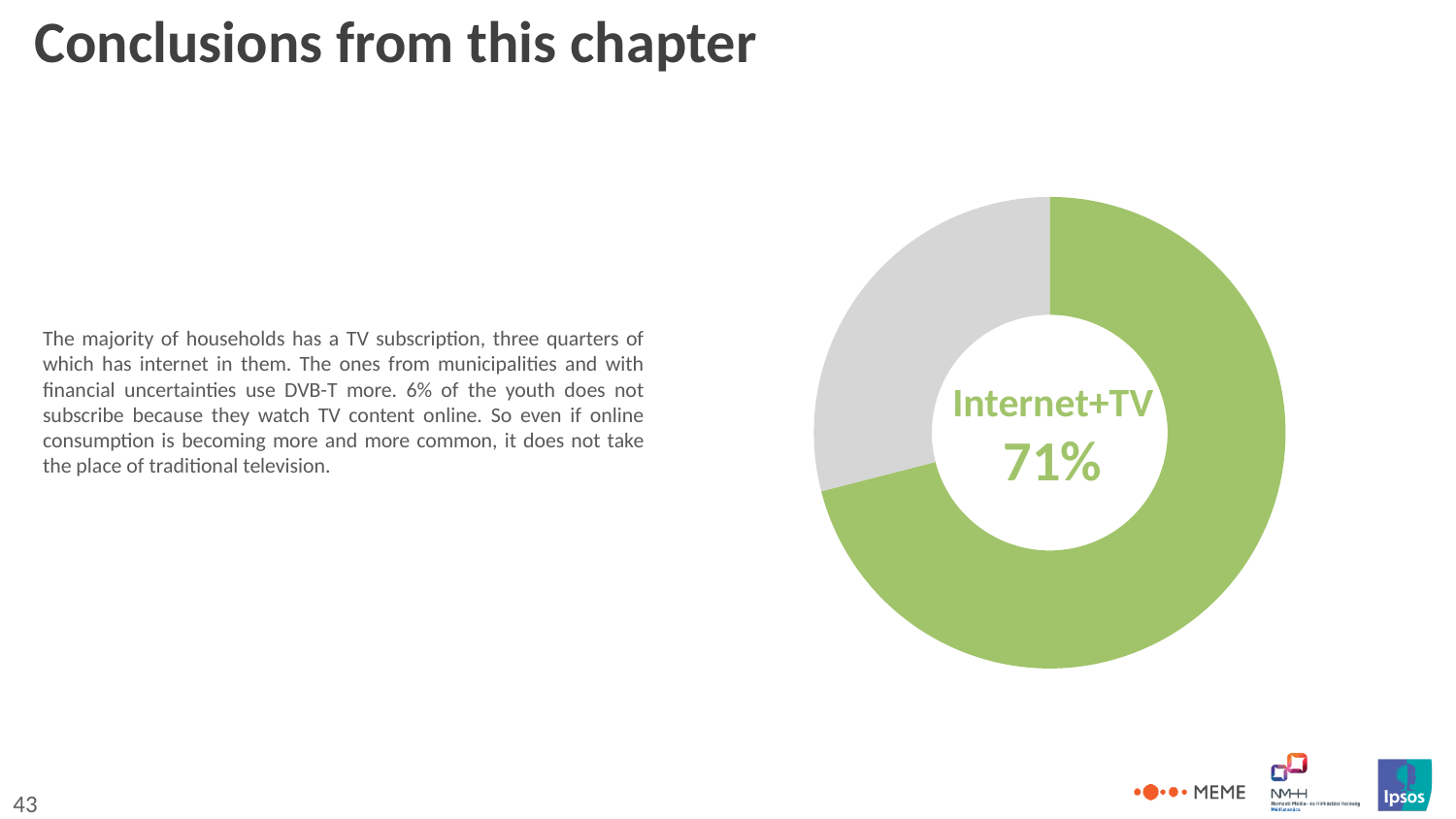
Which slice of the donut chart is larger, the green Internet+TV slice or the grey slice? The green Internet+TV slice How many slices does the donut chart have? 2 What label is printed in the centre of the donut chart? Internet+TV 71% What percentage is shown for Internet+TV in the donut chart? 71% Is the share of the grey slice greater or less than 50%? less Which slice of the donut chart is the largest? Internet+TV What colour is the Internet+TV slice of the donut chart? Green What kind of chart is shown on the slide? Donut (pie) chart Is the share of the Internet+TV slice greater or less than 50%? greater